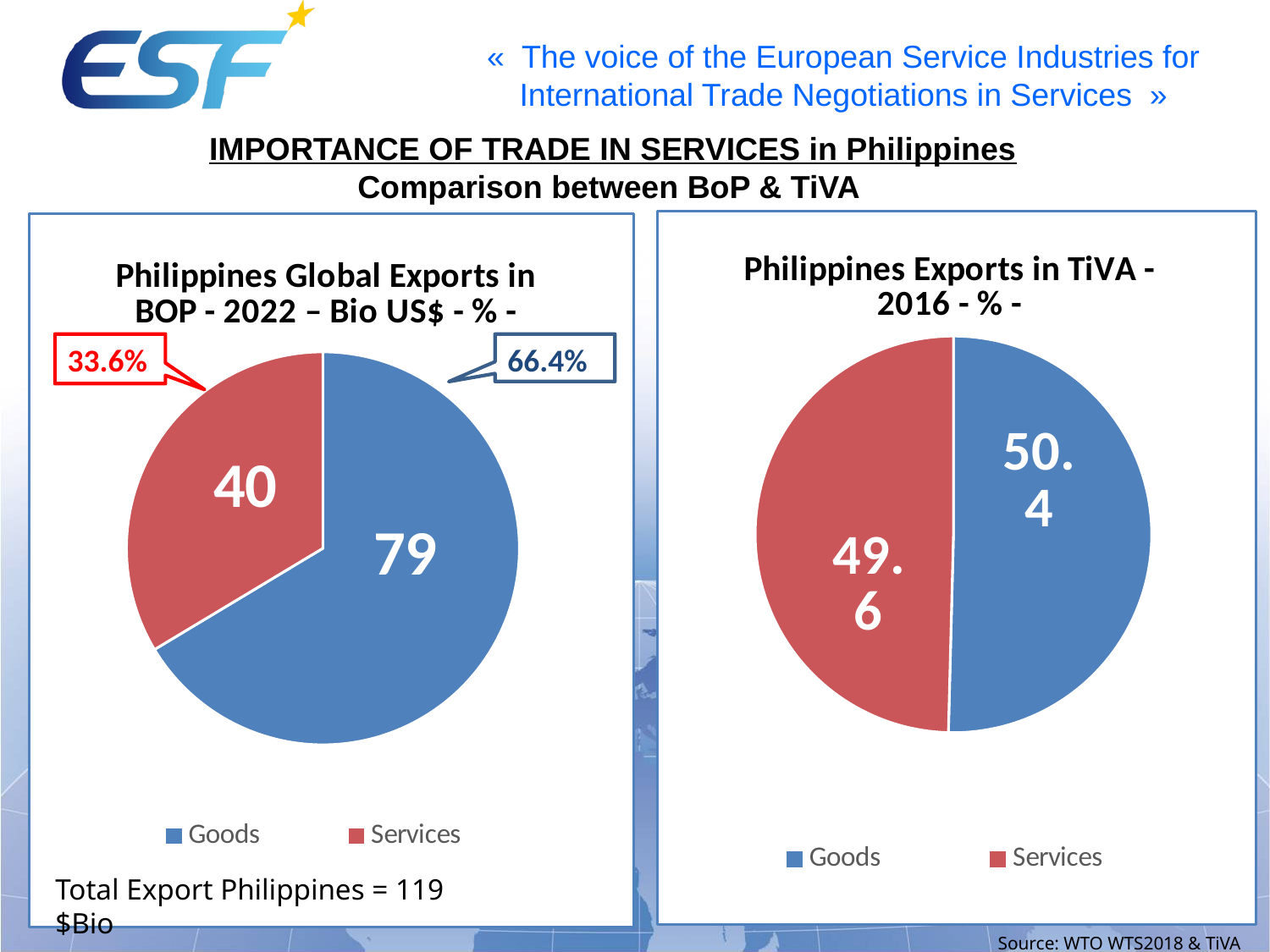
In the 'Philippines Global Exports in BOP - 2022' chart, which colour represents Services? Red In the 'Philippines Global Exports in BOP - 2022' chart, what percentage share is shown in the callout for Goods? 66.4% In the 'Philippines Global Exports in BOP - 2022' chart, which category has the larger value? Goods In the 'Philippines Exports in TiVA - 2016' chart, what is the value for Services? 49.6 How many categories does the legend of the 'Philippines Exports in TiVA - 2016' chart list? 2 What kind of chart is the 'Philippines Exports in TiVA - 2016' chart? Pie chart In the 'Philippines Global Exports in BOP - 2022' chart, what is the value for Goods? 79 In the 'Philippines Exports in TiVA - 2016' chart, what is the value for Goods? 50.4 In the 'Philippines Global Exports in BOP - 2022' chart, what is the value for Services? 40 In the 'Philippines Global Exports in BOP - 2022' chart, what is the total of the Goods and Services values? 119 In the 'Philippines Global Exports in BOP - 2022' chart, what is the difference between the Goods and Services values? 39 In the 'Philippines Global Exports in BOP - 2022' chart, what percentage share is shown in the callout for Services? 33.6%